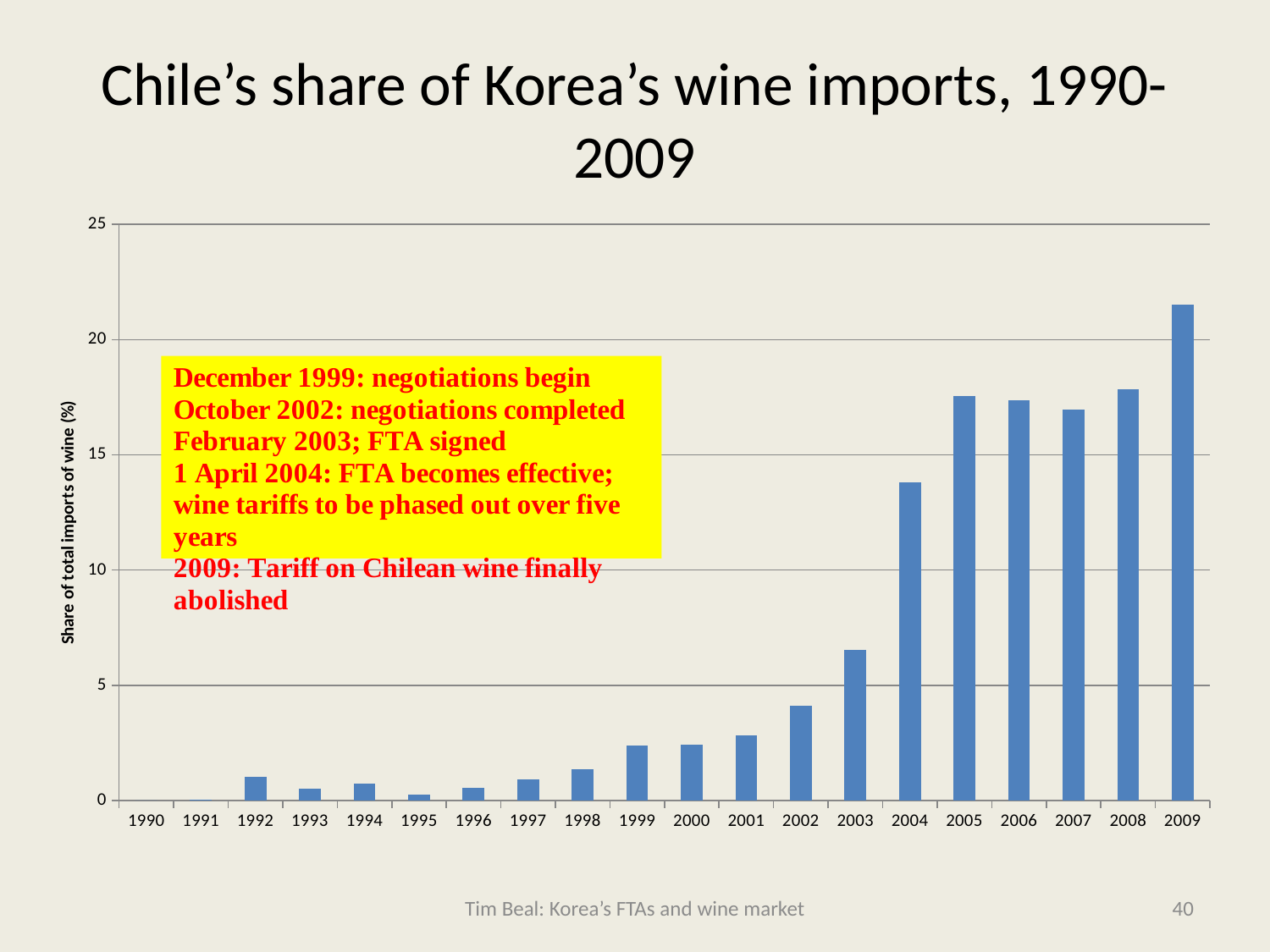
Which year has the larger value, 2003 or 2004? 2004 Is the value for 2002 greater or less than 5? less How many years are shown along the x axis of the chart? 20 What kind of chart is shown on the slide? Bar chart Is the value for 2005 greater or less than 15? greater Overall, do the values rise or fall from 1990 to 2009? Rise Is the value for 2003 greater or less than 5? greater Which year has the highest share of Korea's wine imports from Chile? 2009 Which year has the larger value, 2008 or 2009? 2009 What is the label on the vertical axis of the chart? Share of total imports of wine (%)